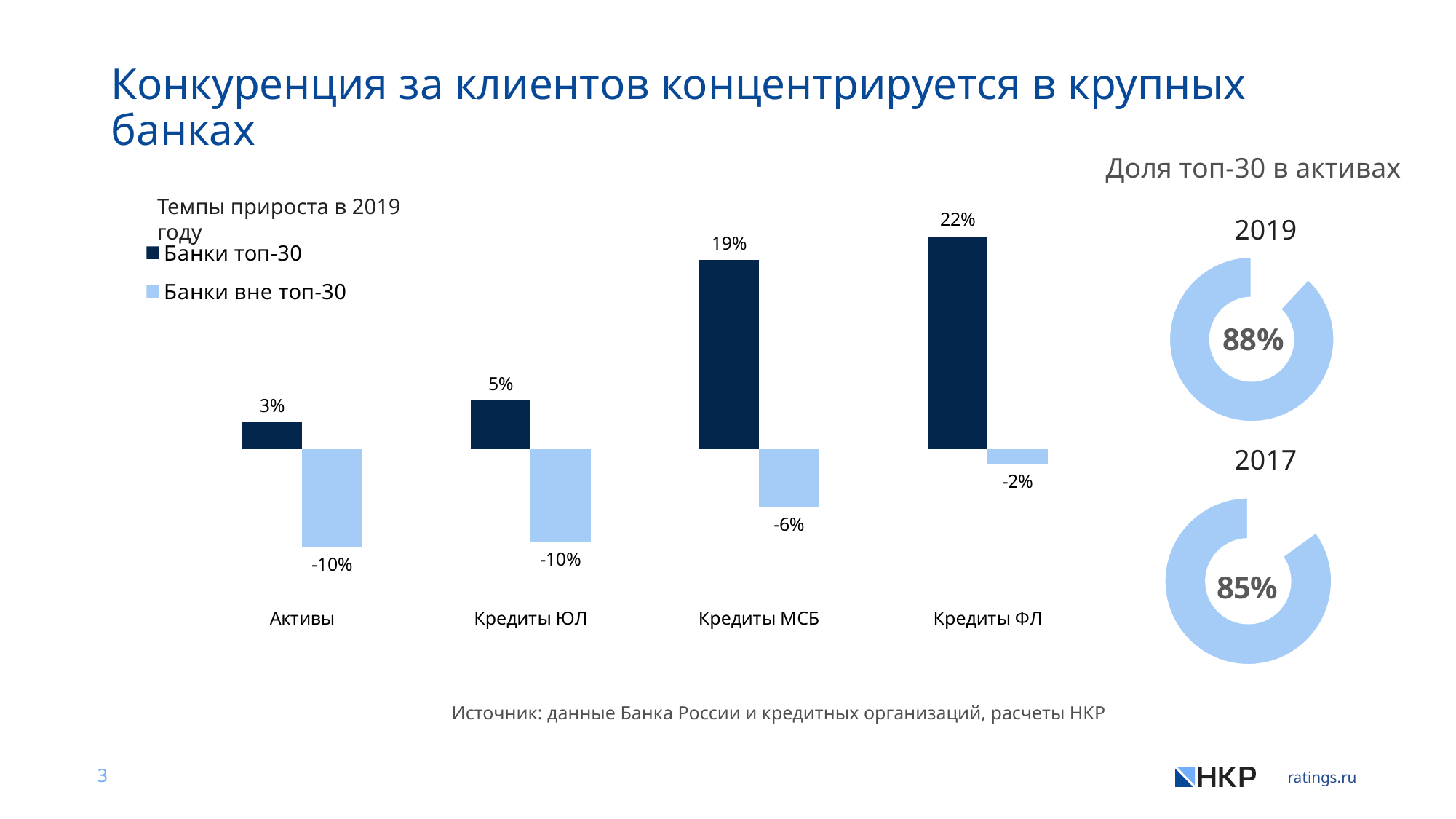
In the 'Доля топ-30 в активах' donut charts on the right, what is the difference between the 2019 share and the 2017 share? 3 percentage points How many series does the legend of the bar chart 'Темпы прироста в 2019 году' list? 2 How many categories are shown on the x axis of the bar chart 'Темпы прироста в 2019 году'? 4 In the bar chart 'Темпы прироста в 2019 году', what is the value for 'Банки вне топ-30' in the category 'Активы'? -10% In the 'Доля топ-30 в активах' donut charts on the right, what is the share shown for 2019? 88% In the bar chart 'Темпы прироста в 2019 году', what is the value for 'Банки топ-30' in the category 'Кредиты МСБ'? 19% What kind of chart is 'Темпы прироста в 2019 году'? Bar chart In the bar chart 'Темпы прироста в 2019 году', what is the value for 'Банки вне топ-30' in the category 'Кредиты ФЛ'? -2% In the bar chart 'Темпы прироста в 2019 году', which is larger for 'Банки вне топ-30': the value for 'Кредиты МСБ' or the value for 'Кредиты ЮЛ'? Кредиты МСБ In the bar chart 'Темпы прироста в 2019 году', which category has the highest value for 'Банки топ-30'? Кредиты ФЛ In the bar chart 'Темпы прироста в 2019 году', which category has the lowest value for 'Банки топ-30'? Активы In the bar chart 'Темпы прироста в 2019 году', what is the difference between the 'Банки топ-30' values for 'Кредиты ФЛ' and 'Кредиты ЮЛ'? 17 percentage points